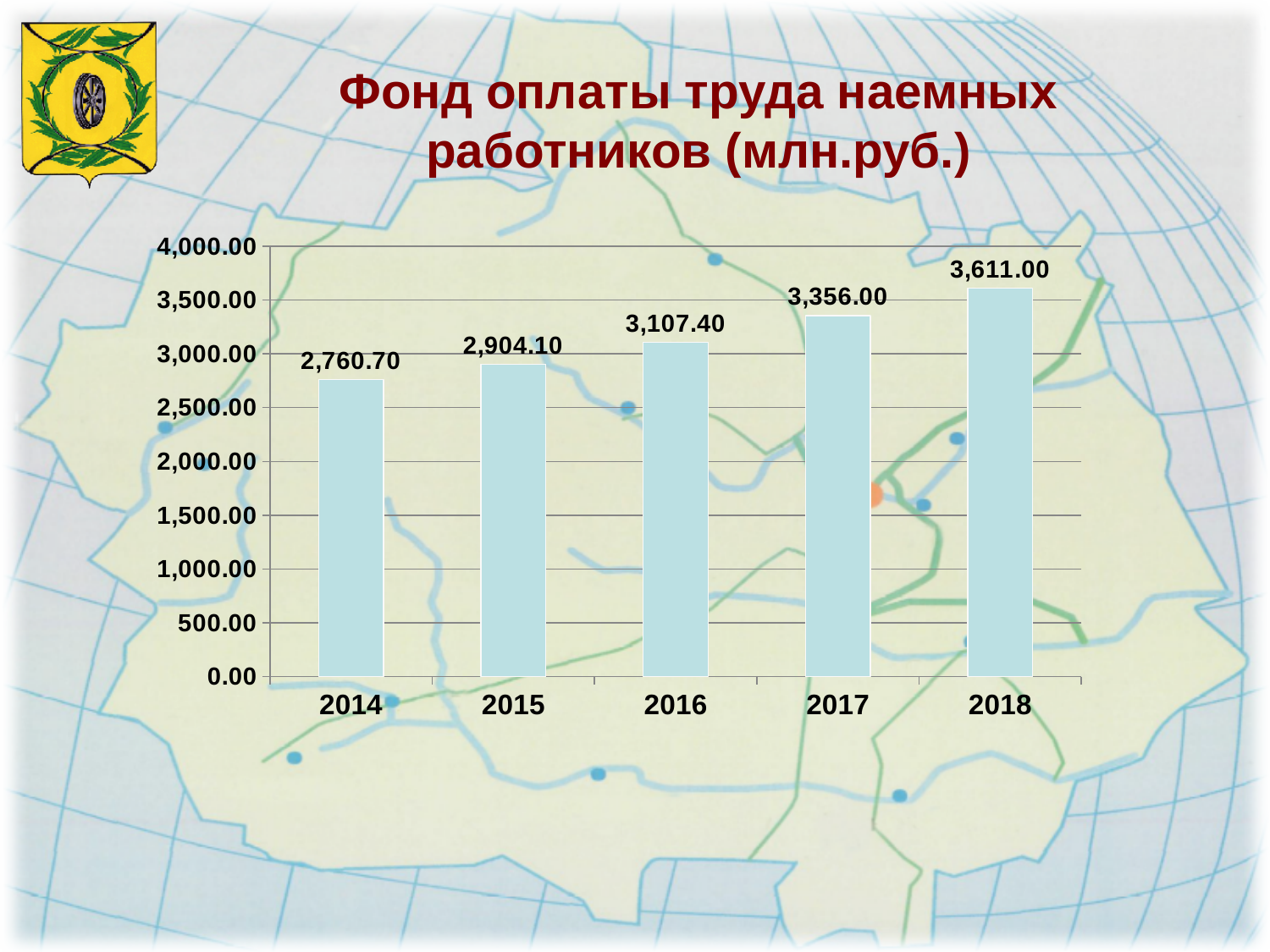
Is the value for 2014 greater or less than 3,000.00? less What is the difference between the values for 2018 and 2014? 850.30 How many years are shown on the x axis? 5 Which is larger, the value for 2015 or the value for 2017? 2017 What is the value for 2014? 2,760.70 Which year has the highest value? 2018 What is the difference between the values for 2017 and 2016? 248.60 What is the value for 2018? 3,611.00 Do the values rise or fall from 2014 to 2018? rise What is the value for 2016? 3,107.40 What kind of chart is shown on the slide? bar chart Which year has the lowest value? 2014